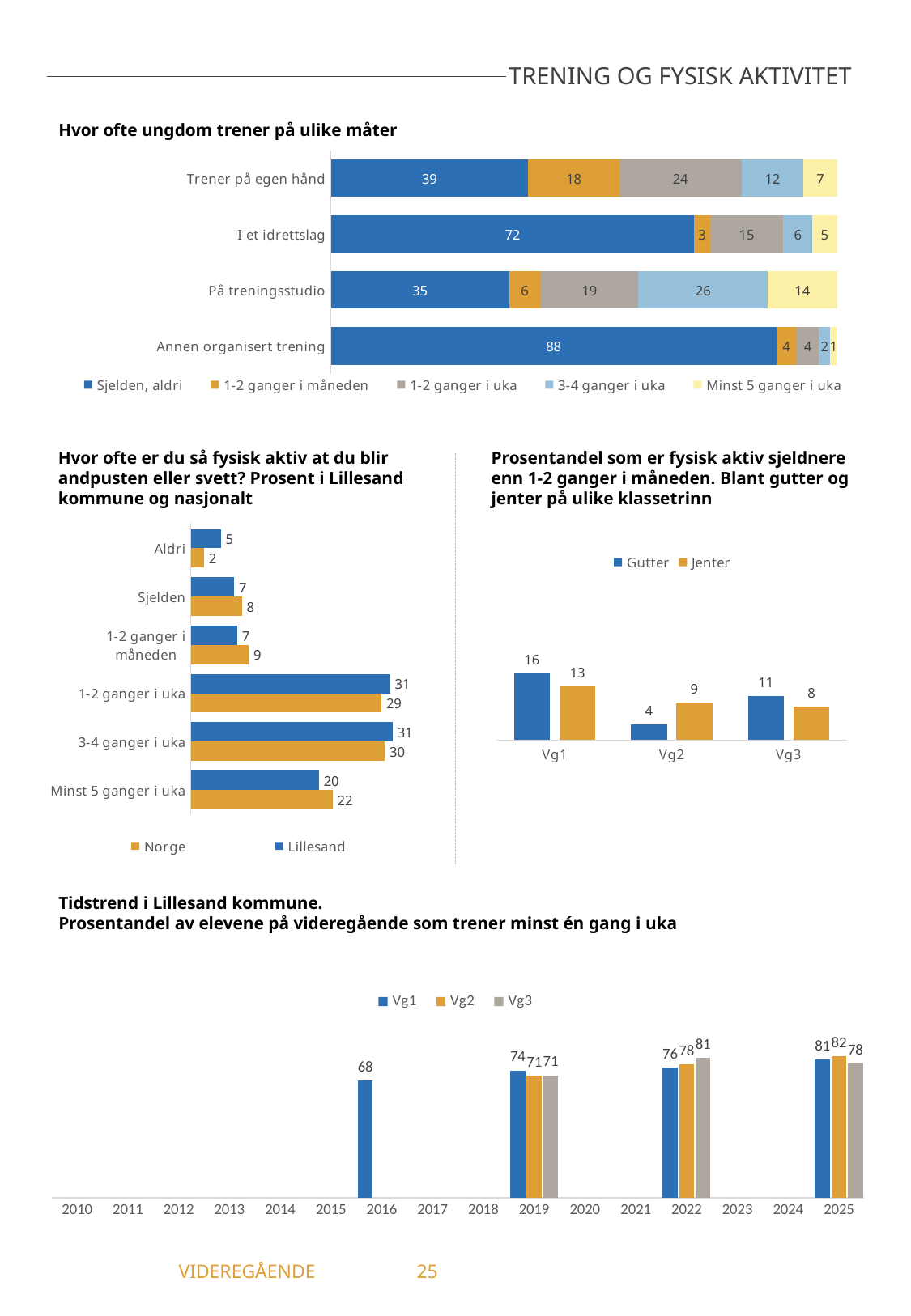
In the chart 'Tidstrend i Lillesand kommune', what is the value for Vg3 in 2022? 81 In the chart 'Hvor ofte ungdom trener på ulike måter', how many series does the legend list? 5 In the chart 'Hvor ofte er du så fysisk aktiv at du blir andpusten eller svett?', how many categories are shown? 6 In the chart 'Hvor ofte ungdom trener på ulike måter', what is the total of the stacked bar for 'Trener på egen hånd'? 100 In the chart 'Prosentandel som er fysisk aktiv sjeldnere enn 1-2 ganger i måneden', which is larger for Vg2, Gutter or Jenter? Jenter In the chart 'Hvor ofte ungdom trener på ulike måter', which category has the highest value for 'Sjelden, aldri'? Annen organisert trening In the chart 'Prosentandel som er fysisk aktiv sjeldnere enn 1-2 ganger i måneden', what is the value for Gutter in Vg1? 16 In the chart 'Hvor ofte er du så fysisk aktiv at du blir andpusten eller svett?', what is the value for Norge for '1-2 ganger i uka'? 29 In the chart 'Prosentandel som er fysisk aktiv sjeldnere enn 1-2 ganger i måneden', which class level has the lowest value for Gutter? Vg2 In the chart 'Tidstrend i Lillesand kommune', do the Vg1 values rise or fall from 2016 to 2025? rise In the chart 'Hvor ofte ungdom trener på ulike måter', what is the value for 'Sjelden, aldri' for 'I et idrettslag'? 72 In the chart 'Hvor ofte er du så fysisk aktiv at du blir andpusten eller svett?', what is the difference between Lillesand and Norge for 'Aldri'? 3